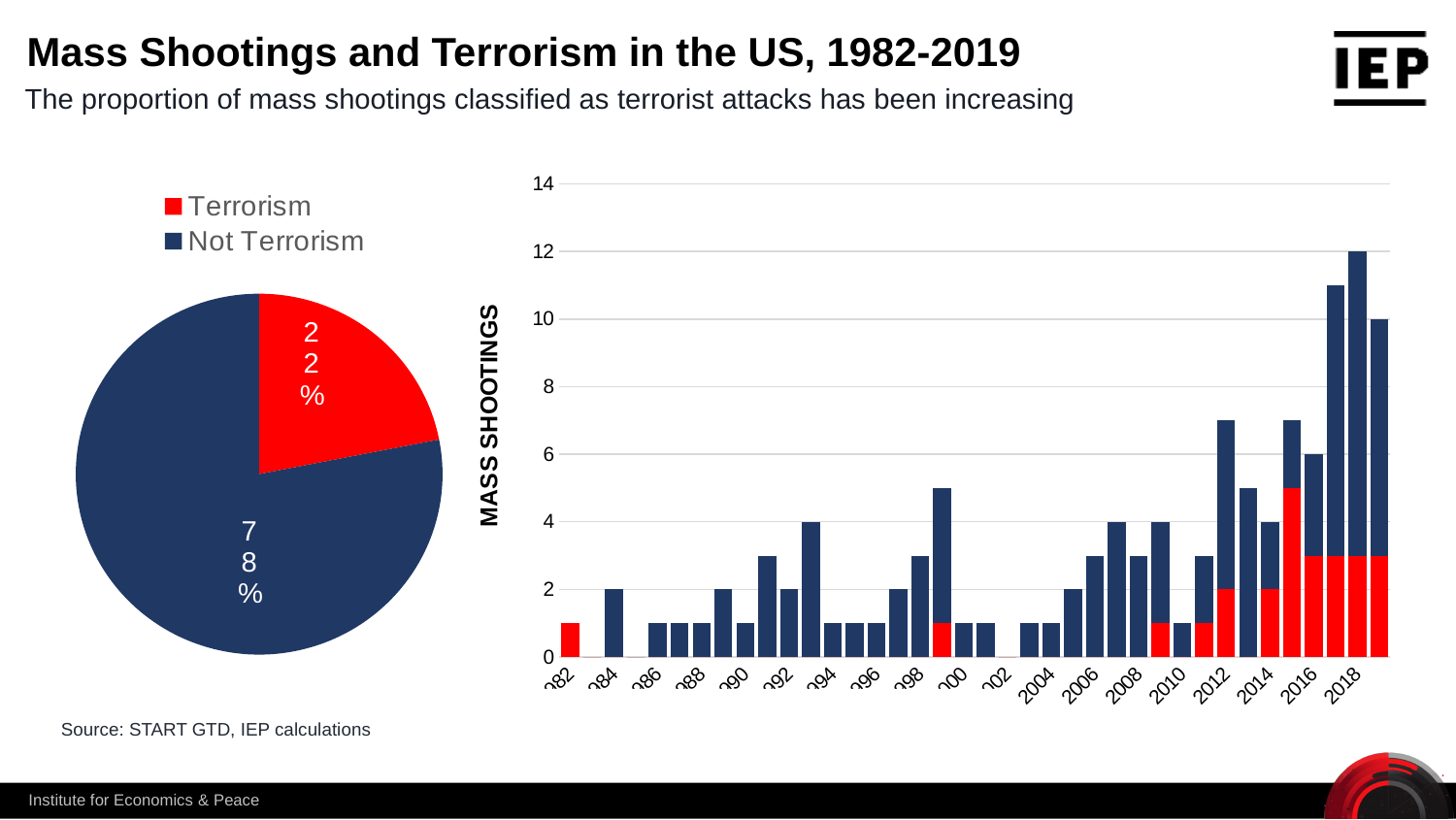
In the bar chart, is the total number of mass shootings for 2017 greater or less than 10? greater In the bar chart, is the total number of mass shootings for 2012 greater or less than 6? greater What kind of chart is the chart on the right of the slide? Stacked bar chart How many series does the legend list? 2 In the pie chart, which slice is larger, Terrorism or Not Terrorism? Not Terrorism In the pie chart, what share of mass shootings is classified as Terrorism? 22% What colour represents Terrorism in the charts? Red In the pie chart, by how many percentage points does the Not Terrorism share exceed the Terrorism share? 56 percentage points In the bar chart, how many mass shootings are shown for 2018? 12 In the pie chart, what share of mass shootings is classified as Not Terrorism? 78% In the bar chart, do the number of mass shootings generally rise or fall from 1982 to 2019? Rise In the bar chart, which year has the highest number of mass shootings? 2018